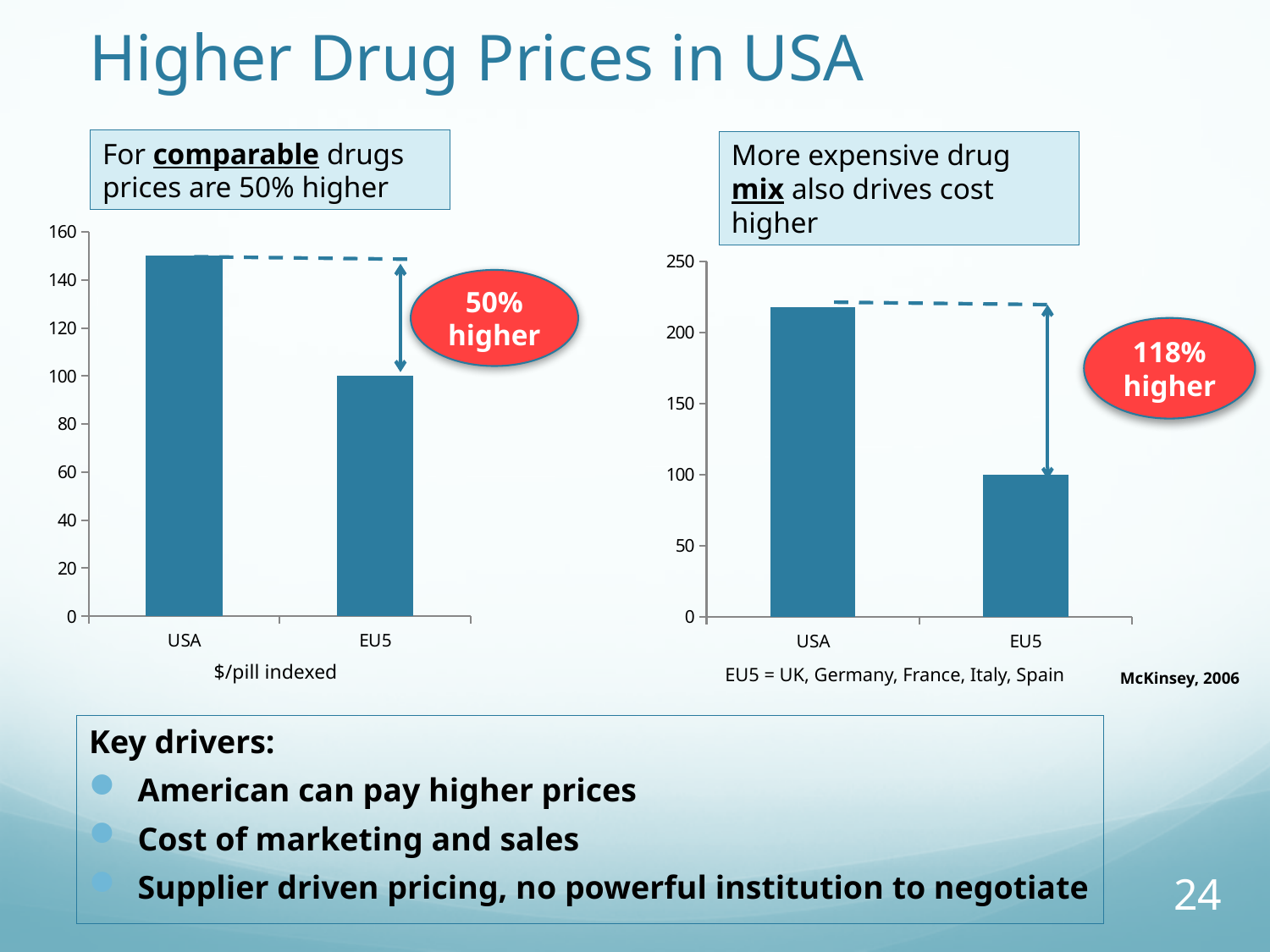
What kind of chart is the left chart? bar chart In the right chart, what is the value for EU5? 100 In the left chart, which is larger, the value for USA or the value for EU5? USA In the left chart, is the value for USA greater or less than 140? greater According to the callout on the right chart, by what percentage is the USA value higher than EU5? 118% higher In the right chart, which category has the lowest value? EU5 In the left chart, what is the value for EU5? 100 In the left chart, which category has the highest value? USA How many categories are shown in the right chart? 2 What is the axis label shown below the left chart? $/pill indexed In the right chart, is the value for USA greater or less than 250? less In the right chart, is the value for USA greater or less than 200? greater